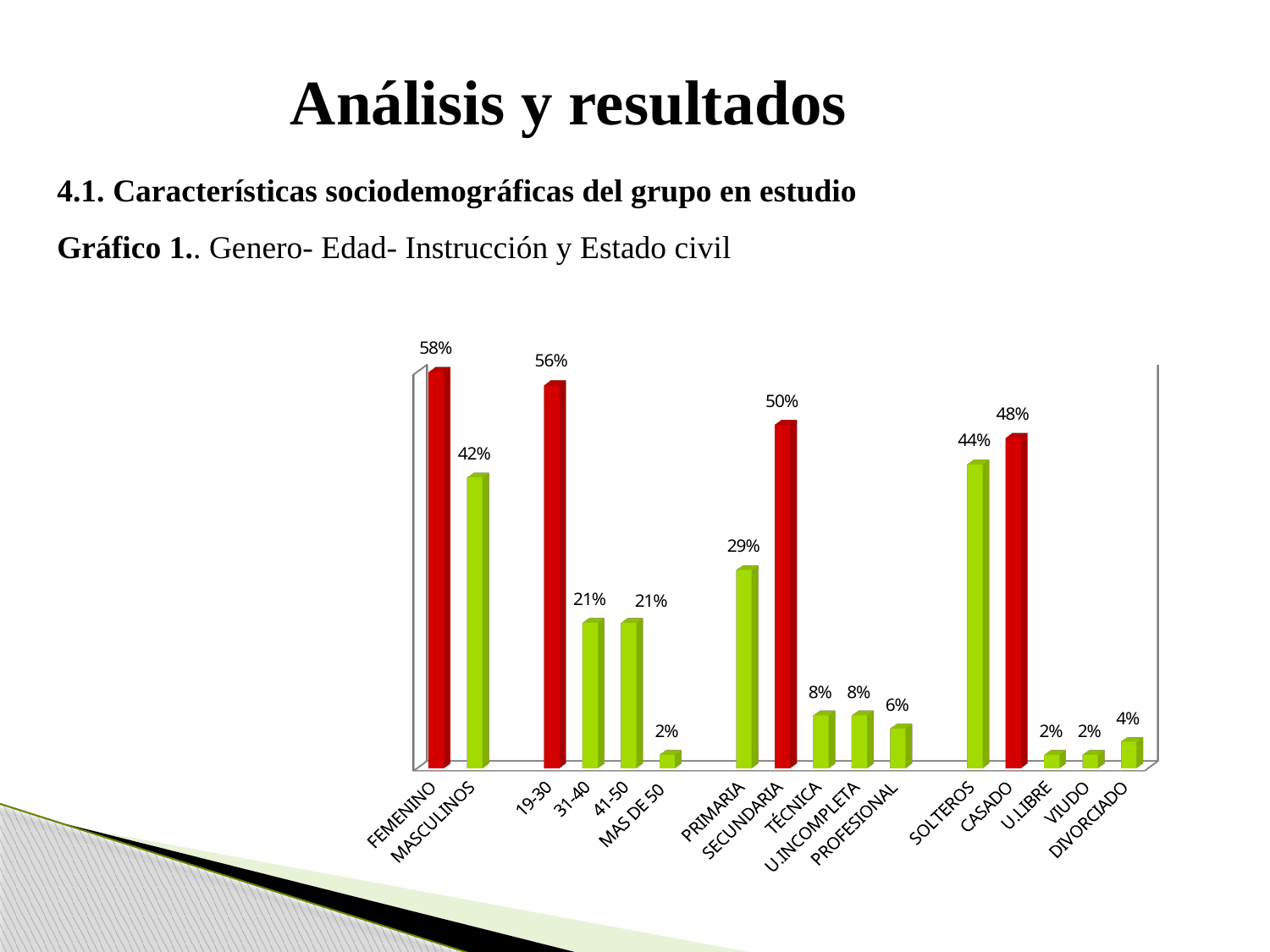
What is the value for CASADO? 48% Which category has the highest value in the chart? FEMENINO Which is larger, the value for 19-30 or the value for 31-40? 19-30 What is the difference between the values for CASADO and SOLTEROS? 4% How many categories are shown on the x axis of the chart? 16 What is the difference between the values for FEMENINO and MASCULINOS? 16% Which is larger, the value for PRIMARIA or the value for SECUNDARIA? SECUNDARIA What is the value for SECUNDARIA? 50% What is the value for MAS DE 50? 2% What is the value for FEMENINO? 58% What kind of chart is shown on the slide? Bar chart What is the value for MASCULINOS? 42%